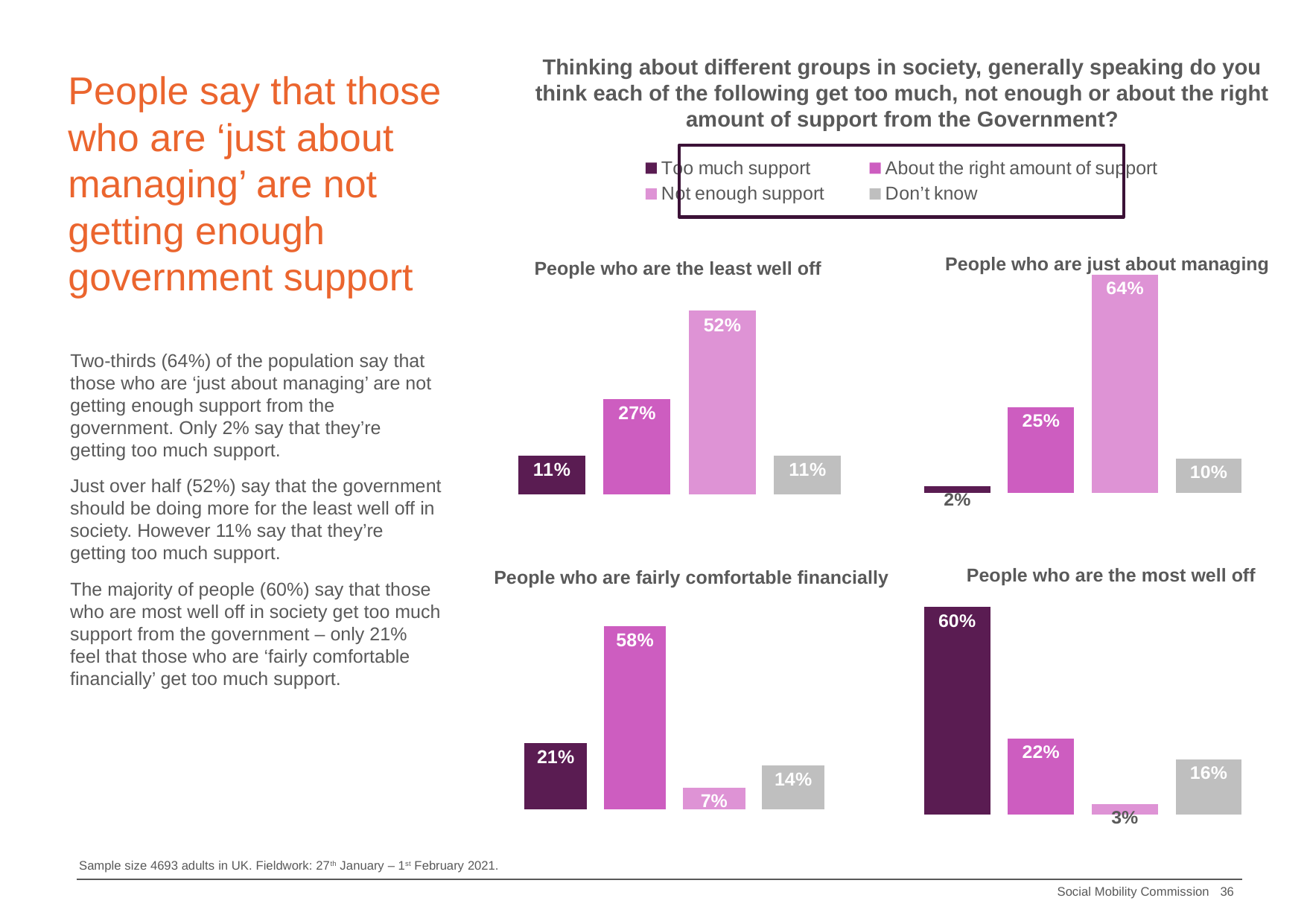
What type of chart is used for 'People who are the most well off'? Bar chart In the 'People who are just about managing' chart, what percentage say they get too much support? 2% In the 'People who are the least well off' chart, which is larger: 'Too much support' or 'About the right amount of support'? About the right amount of support In the 'People who are the most well off' chart, which response has the highest value? Too much support In the 'People who are fairly comfortable financially' chart, which response has the lowest value? Not enough support How many response categories does the legend list? 4 In the 'People who are the least well off' chart, what percentage say they get not enough support? 52% In the 'People who are just about managing' chart, what is the difference between the 'Not enough support' and 'About the right amount of support' values? 39 percentage points In the 'People who are fairly comfortable financially' chart, what percentage say they get about the right amount of support? 58% In the 'People who are the most well off' chart, what percentage answered 'Don't know'? 16% In the 'People who are the most well off' chart, what is the difference between 'Too much support' and 'About the right amount of support'? 38 percentage points How many separate charts are shown on the slide? 4